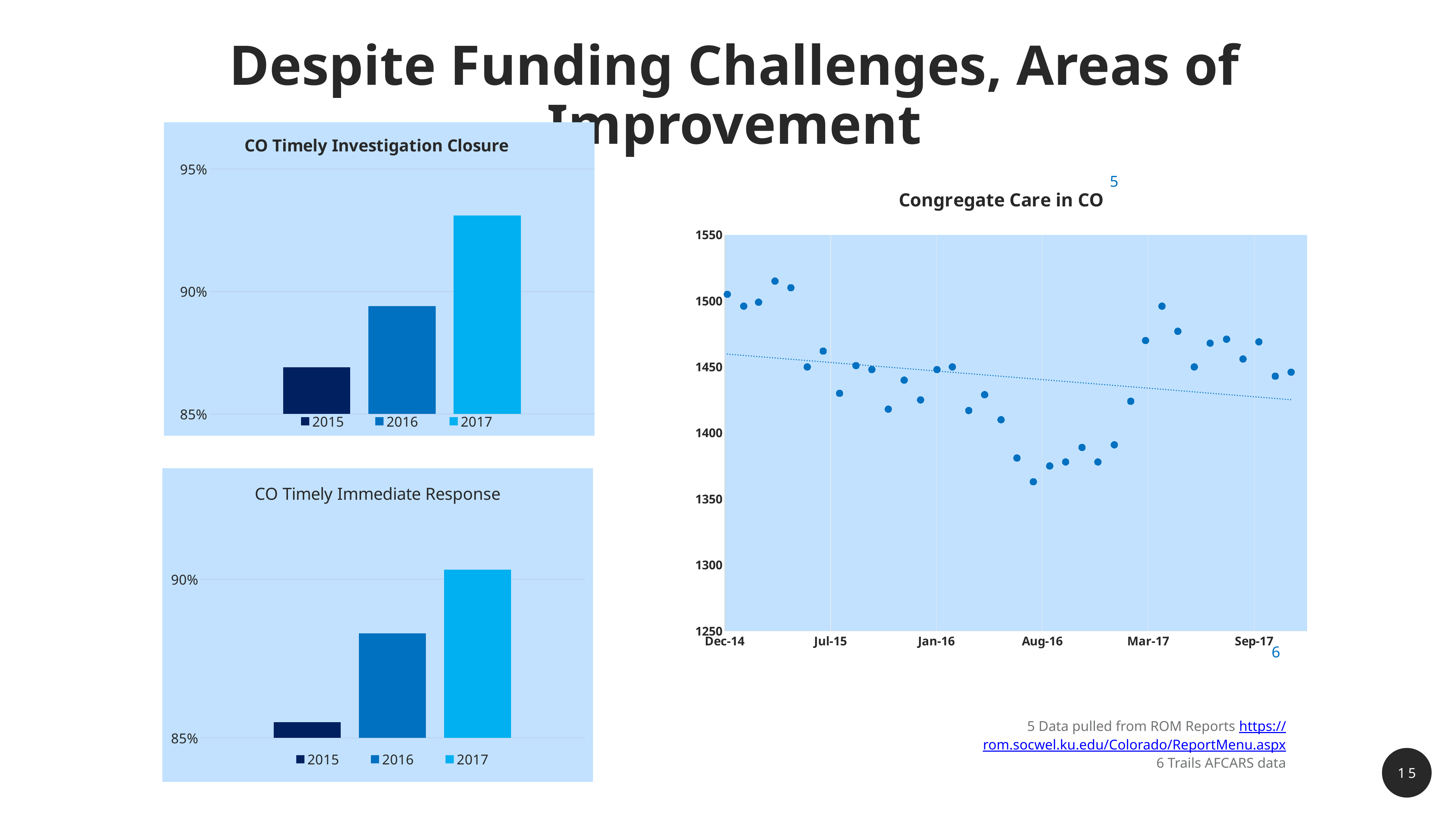
In the "CO Timely Immediate Response" chart, which is larger, the value for 2016 or the value for 2015? 2016 In the "CO Timely Investigation Closure" chart, is the value for 2017 greater or less than 90%? greater Do the values in the "CO Timely Immediate Response" chart rise or fall from 2015 to 2017? rise In the "Congregate Care in CO" chart, is the lowest point greater or less than 1400? less How many years are shown in the "CO Timely Immediate Response" chart? 3 In the "CO Timely Investigation Closure" chart, is the value for 2015 greater or less than 90%? less In the "Congregate Care in CO" chart, does the dotted trend line rise or fall from Dec-14 to Sep-17? fall What kind of chart is "CO Timely Investigation Closure"? bar chart In the "CO Timely Investigation Closure" chart, which year has the lowest value? 2015 In the "CO Timely Investigation Closure" chart, which year has the highest value? 2017 What kind of chart is "Congregate Care in CO"? scatter chart